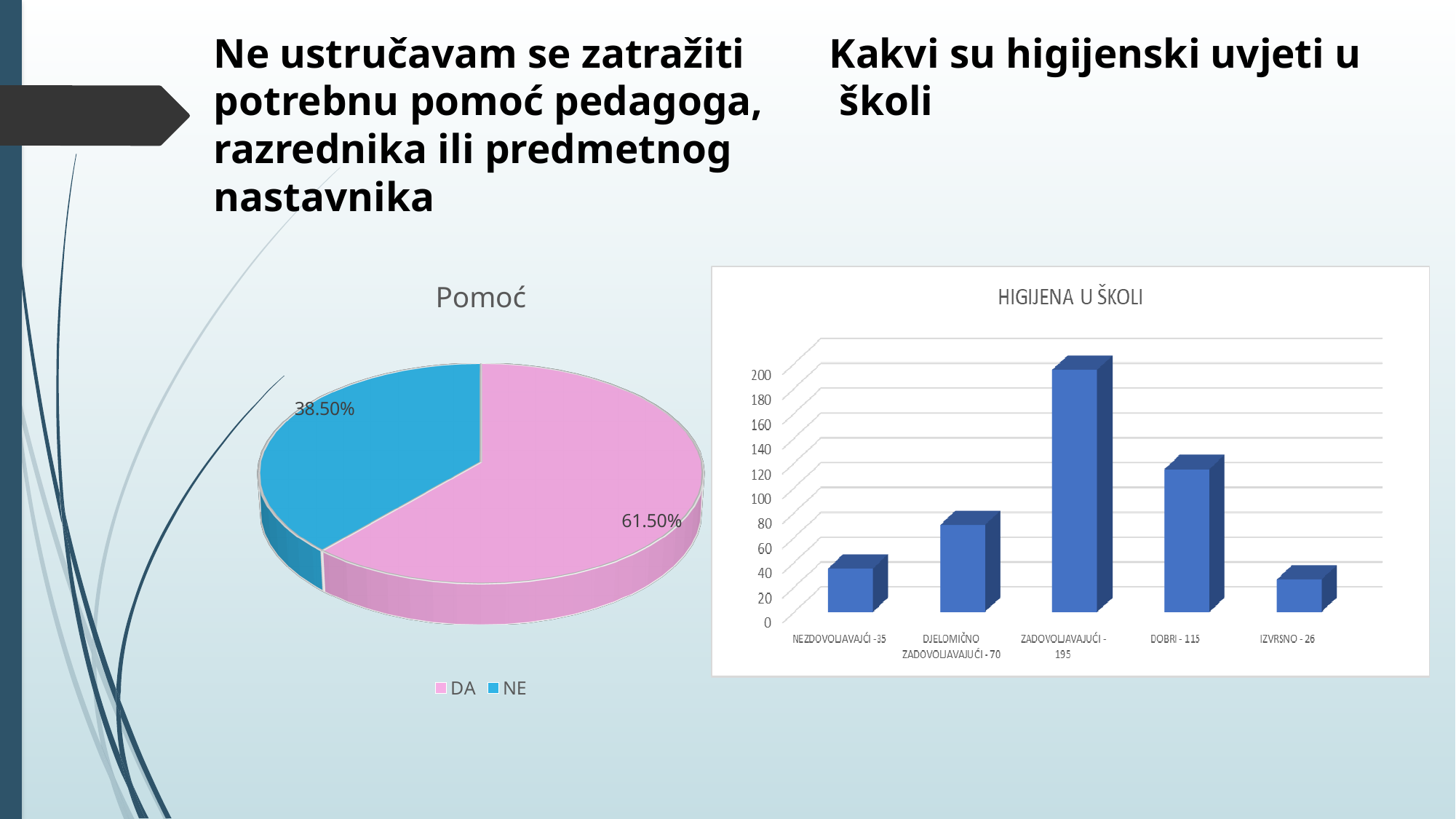
In the 'HIGIJENA U ŠKOLI' chart, which category has the highest value? ZADOVOLJAVAJUĆI In the 'HIGIJENA U ŠKOLI' chart, what is the value for DOBRI? 115 In the 'Pomoć' pie chart, what percentage is shown for DA? 61.50% What type of chart is the 'Pomoć' chart? Pie chart In the 'HIGIJENA U ŠKOLI' chart, which category has the lowest value? IZVRSNO In the 'HIGIJENA U ŠKOLI' chart, what is the value for ZADOVOLJAVAJUĆI? 195 How many categories are shown in the 'HIGIJENA U ŠKOLI' bar chart? 5 How many entries does the legend of the 'Pomoć' pie chart list? 2 In the 'HIGIJENA U ŠKOLI' chart, what is the difference between the values for DJELOMIČNO ZADOVOLJAVAJUĆI and NEZDOVOLJAVAJUĆI? 35 In the 'Pomoć' pie chart, which slice is larger, DA or NE? DA In the 'Pomoć' pie chart, what percentage is shown for NE? 38.50% In the 'Pomoć' pie chart, what is the difference in percentage points between DA and NE? 23 percentage points